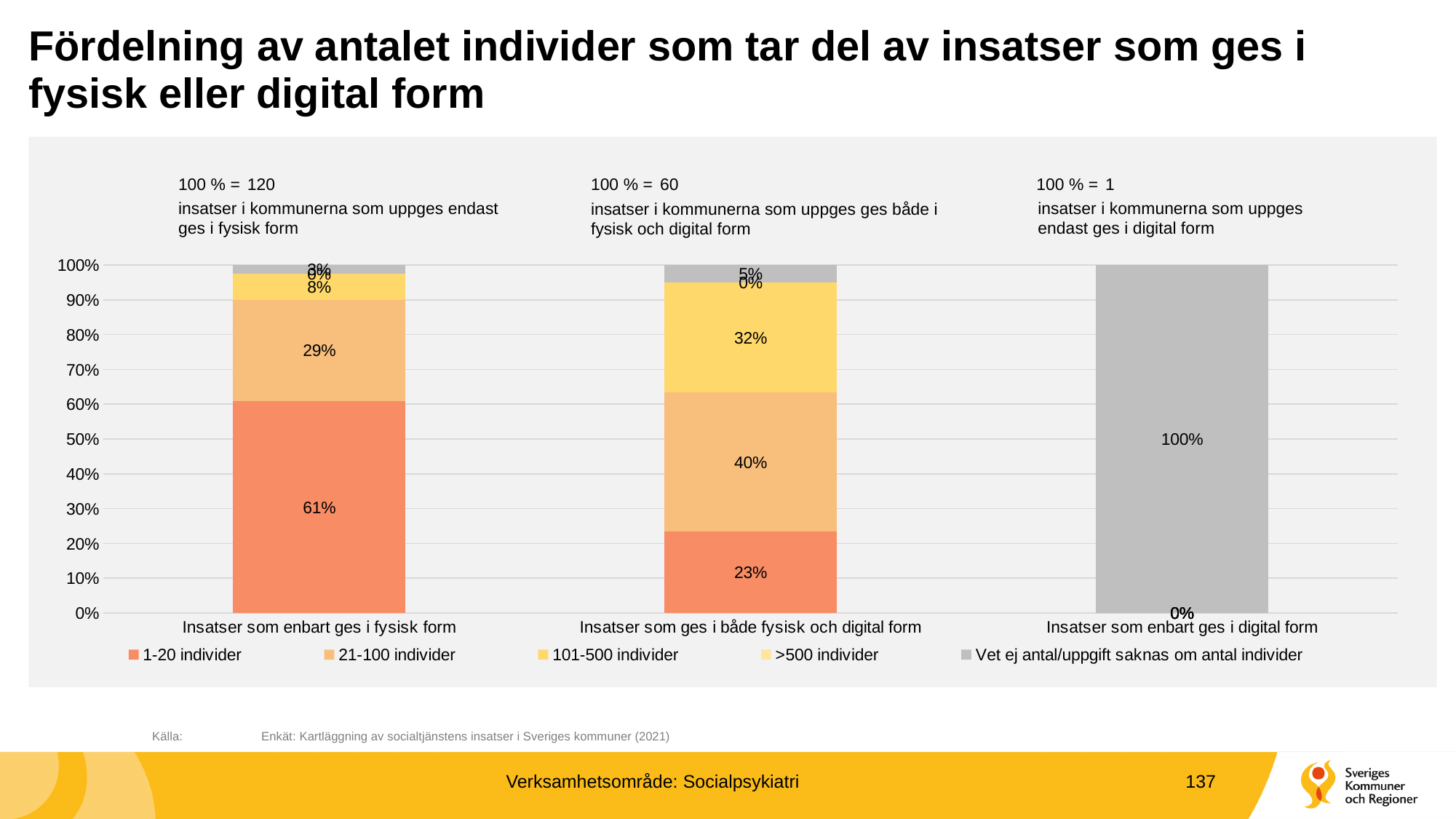
What is the value for 'Vet ej antal/uppgift saknas om antal individer' in the category 'Insatser som enbart ges i digital form'? 100% What is the value for 1-20 individer in the category 'Insatser som ges i både fysisk och digital form'? 23% How many series does the legend list? 5 Which category has the highest share of 1-20 individer? Insatser som enbart ges i fysisk form What is the value for 1-20 individer in the category 'Insatser som enbart ges i fysisk form'? 61% What is the difference between the 1-20 individer share in 'Insatser som enbart ges i fysisk form' and in 'Insatser som ges i både fysisk och digital form'? 38 percentage points What is the value for 21-100 individer in the category 'Insatser som ges i både fysisk och digital form'? 40% What kind of chart is shown on the slide? stacked bar chart How many categories are shown on the x axis? 3 According to the note above the chart, how many insatser does 100 % correspond to for the category 'Insatser som enbart ges i fysisk form'? 120 Which is larger: the 21-100 individer share in 'Insatser som enbart ges i fysisk form' or in 'Insatser som ges i både fysisk och digital form'? Insatser som ges i både fysisk och digital form What is the value for 101-500 individer in the category 'Insatser som ges i både fysisk och digital form'? 32%